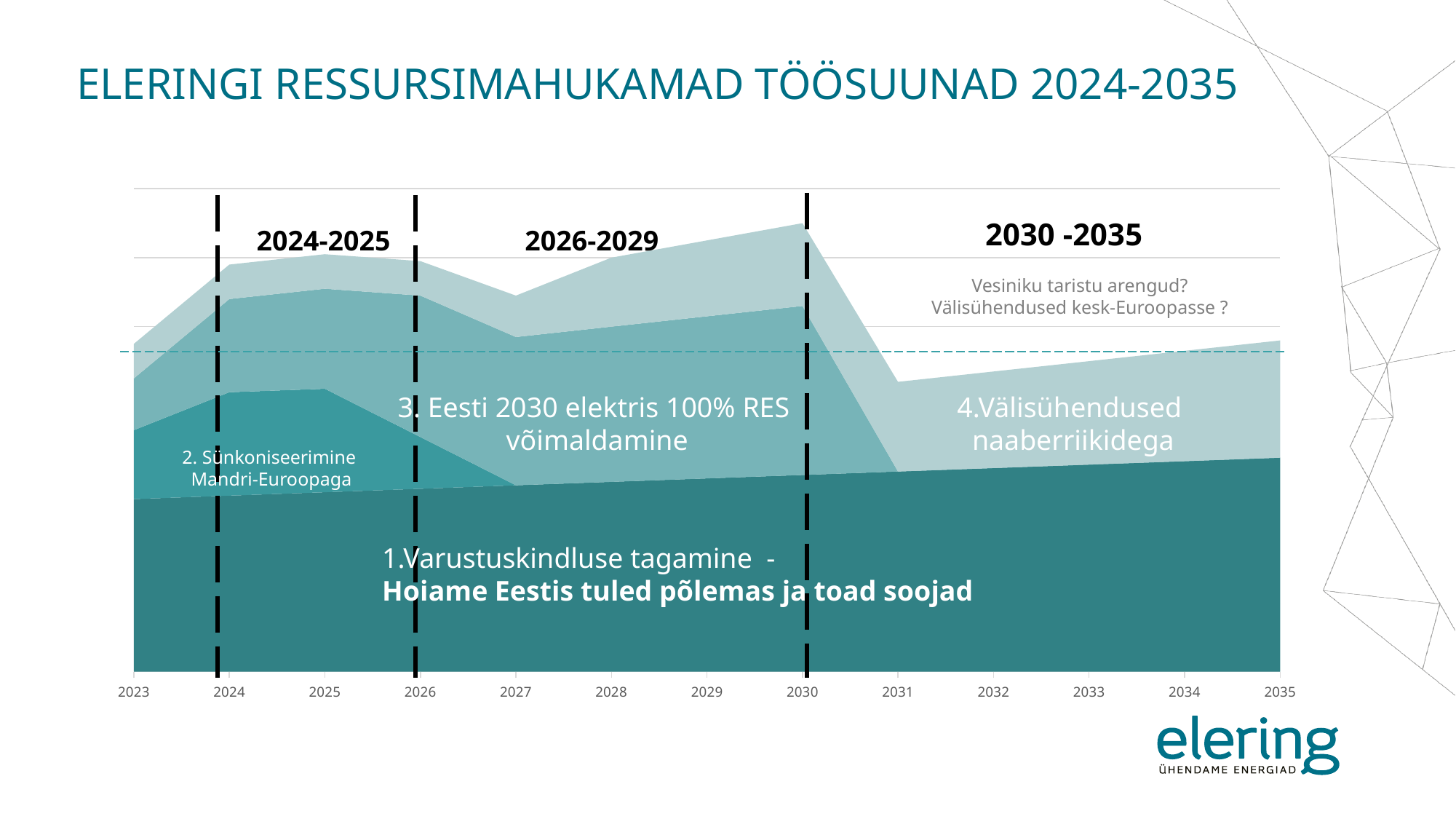
What kind of chart is shown on the slide? Stacked area chart What is the last year shown on the x axis of the chart? 2035 How many labelled areas (work directions) are stacked in the chart? 4 What is the first year shown on the x axis of the chart? 2023 In which year does the total stacked height of the chart reach its highest point? 2030 How many years are labelled on the x axis of the chart? 13 Is the total stacked height of the chart larger in 2030 or in 2031? 2030 Is the total stacked height of the chart larger in 2025 or in 2027? 2025 Which labelled area lies at the bottom of the stacked chart? 1.Varustuskindluse tagamine Does the bottom area '1.Varustuskindluse tagamine' rise or fall from 2023 to 2035? Rises Does the total stacked height of the chart rise or fall between 2030 and 2031? Falls